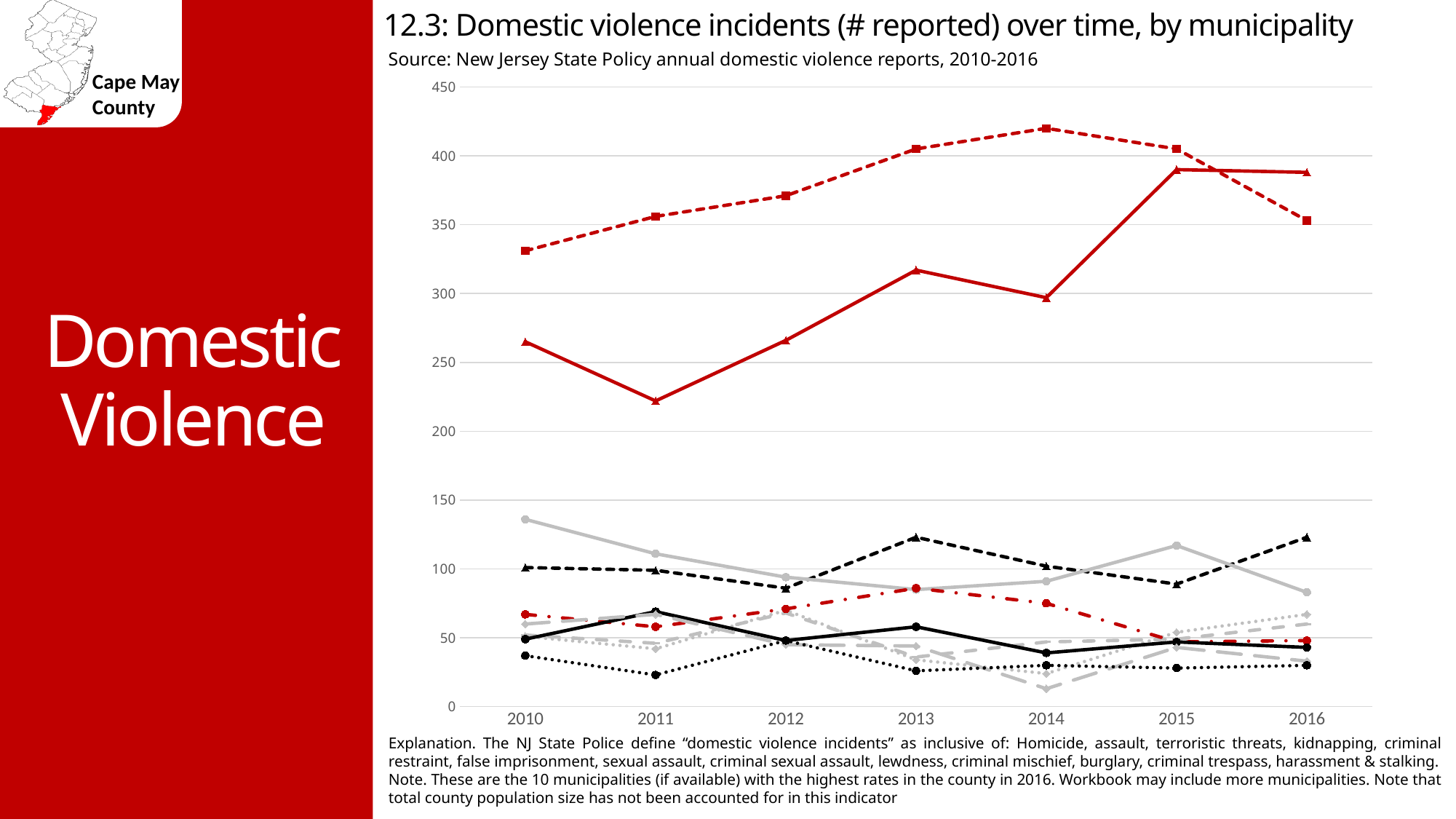
What is the title of the chart? 12.3: Domestic violence incidents (# reported) over time, by municipality Is the value of the grey solid line with circle markers in 2010 greater or less than 150? less Does the red dashed line with square markers rise or fall from 2010 to 2014? rises In 2016, which is higher: the red dashed line with square markers or the red solid line with triangle markers? the red solid line with triangle markers Is the value of the black dashed line with triangle markers in 2013 greater or less than 100? greater How many years are shown along the x axis of the chart? 7 Is the value of the red dashed line with square markers in 2014 greater or less than 400? greater In which year does the red solid line with triangle markers reach its lowest value? 2011 In which year does the red dashed line with square markers reach its highest value? 2014 What source is cited for the chart data? New Jersey State Policy annual domestic violence reports, 2010-2016 What kind of chart is shown on the slide? line chart